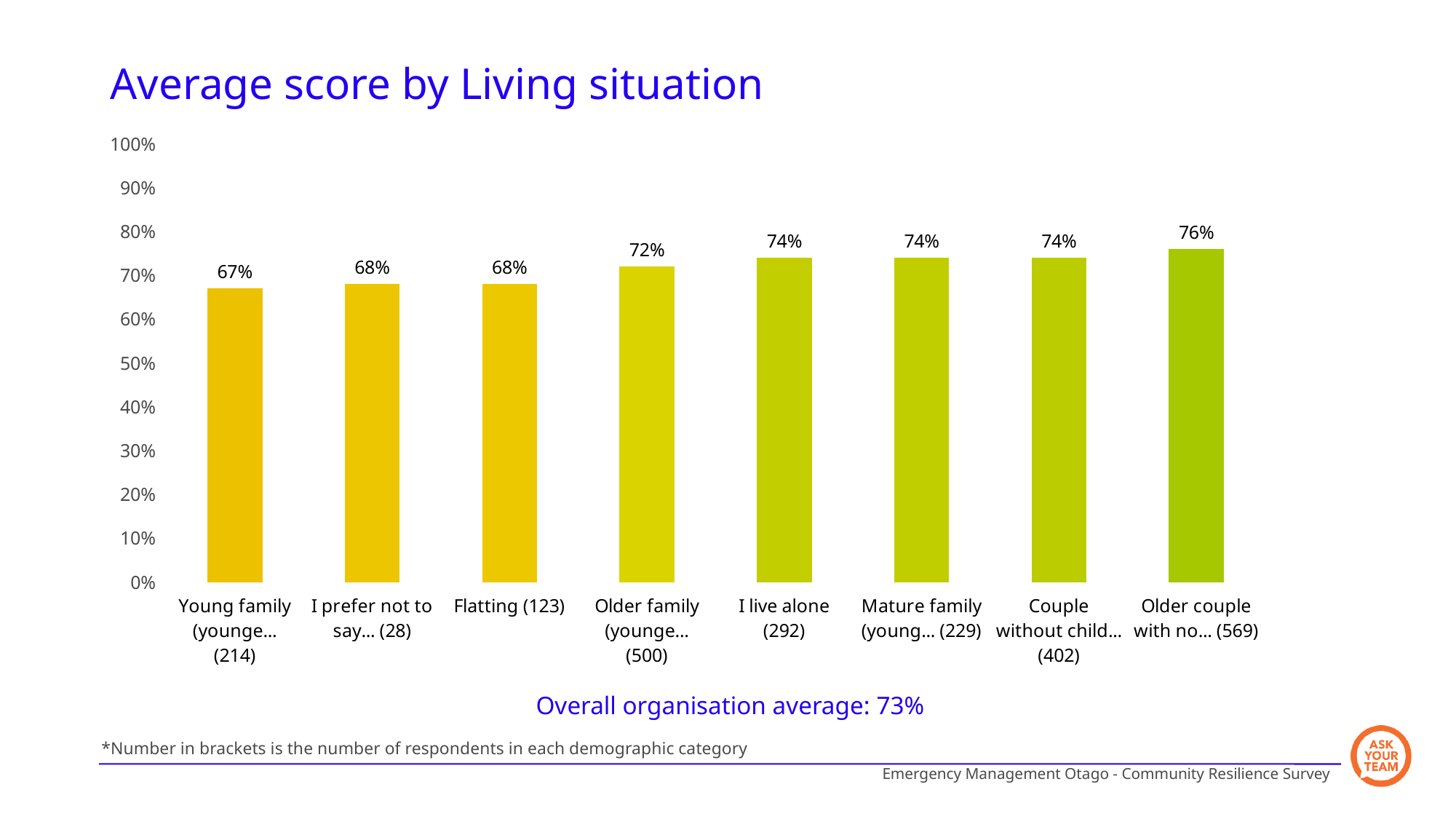
What is the average score for the Young family category? 67% Is the average score for I prefer not to say... (28) greater or less than 70%? less Which has a higher average score: Older family (500) or Flatting (123)? Older family (500) How many living situation categories are shown in the chart? 8 What is the average score for Flatting (123)? 68% Do the average scores rise or fall moving from left to right across the categories? rise Which living situation has the highest average score? Older couple with no... (569) What is the difference between the average score for Older couple with no... (569) and Young family (214)? 9% What is the average score for I live alone (292)? 74% What type of chart is shown on the slide? bar chart Which living situation has the lowest average score? Young family (younge... (214) What is the overall organisation average stated on the slide? 73%